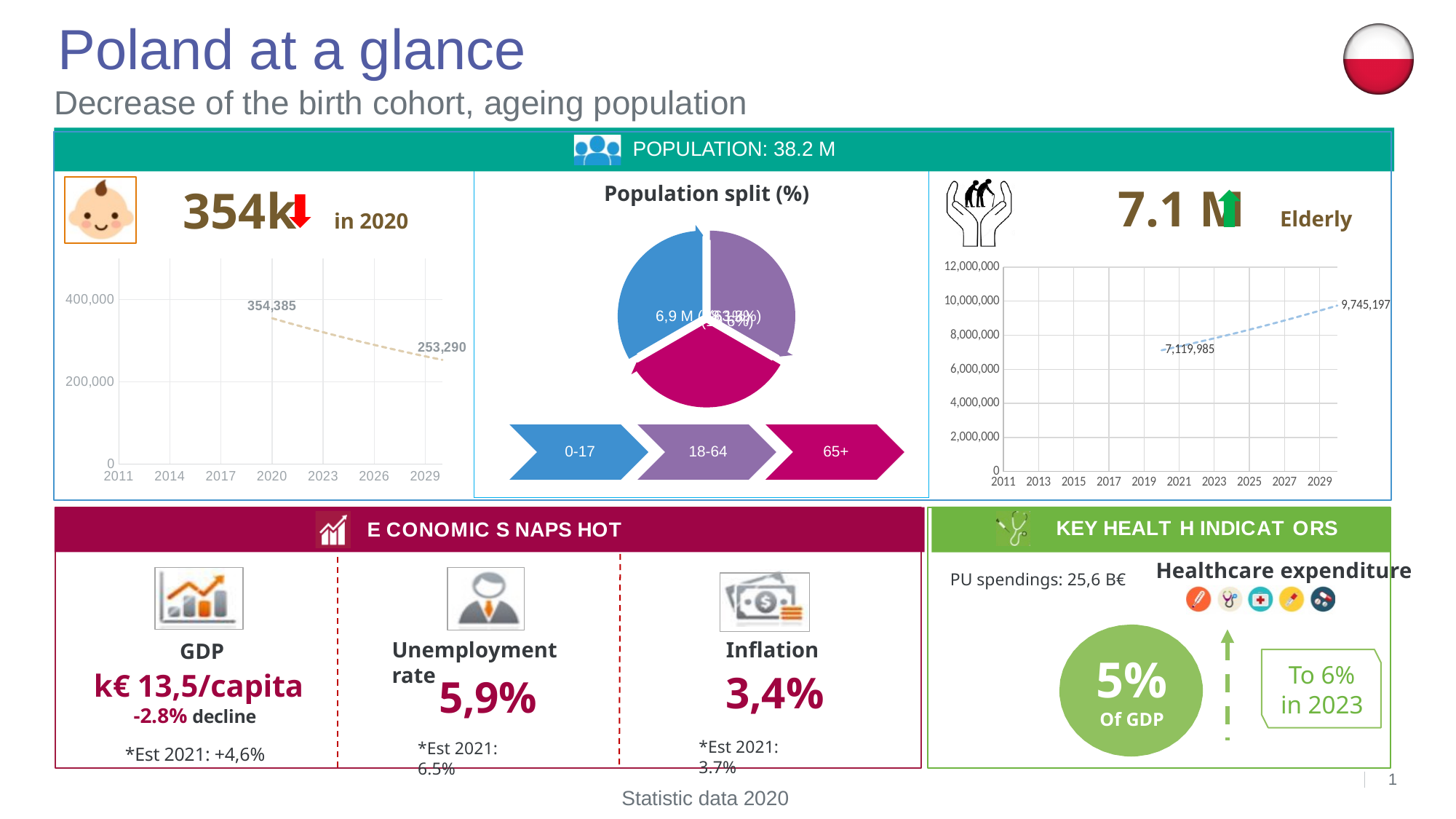
In the birth cohort chart on the left, what value is labelled for 2029? 253,290 What kind of chart is the 'Population split (%)' chart? pie chart In the elderly population chart on the right, what is the difference between the 2029 value and the 2021 value? 2,625,212 In the birth cohort chart on the left, do the values rise or fall from 2020 to 2029? fall In the elderly population chart on the right, what value is labelled for 2021? 7,119,985 In the birth cohort chart on the left, what is the difference between the 2020 value and the 2029 value? 101,095 In the birth cohort chart on the left, is the value for 2029 greater or less than 400,000? less How many slices does the 'Population split (%)' pie chart have? 3 In the birth cohort chart on the left, what value is labelled for 2020? 354,385 Which age group does the blue slice of the 'Population split (%)' pie chart represent? 0-17 In the elderly population chart on the right, what value is labelled for 2029? 9,745,197 In the elderly population chart on the right, do the values rise or fall from 2021 to 2029? rise